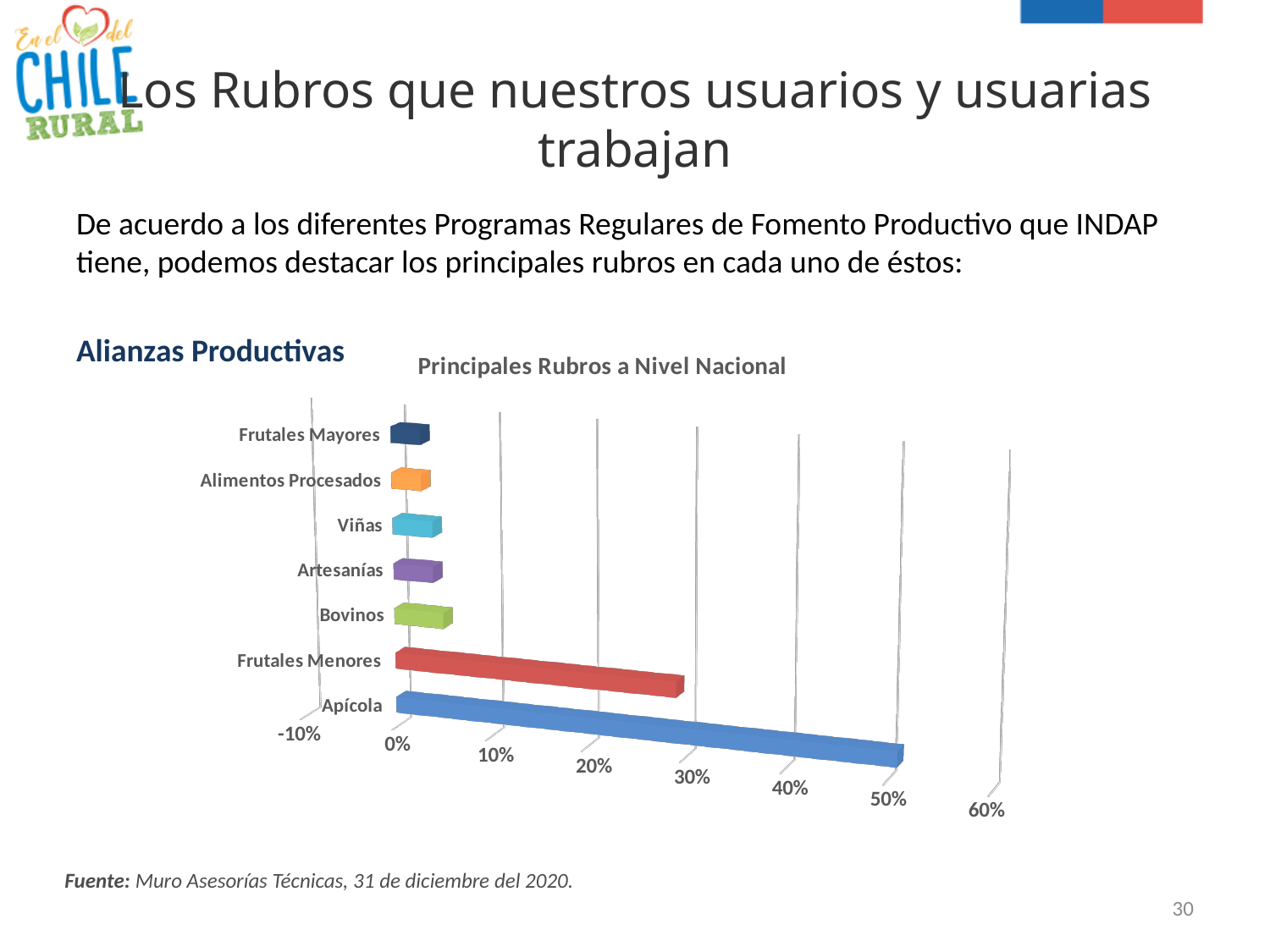
Is the value for Apícola greater or less than 40%? greater What is the title of the chart? Principales Rubros a Nivel Nacional Is the value for Bovinos greater or less than 10%? less Is the value for Frutales Menores greater or less than 20%? greater Which is larger, the value for Frutales Menores or the value for Bovinos? Frutales Menores What is the highest tick label shown on the value axis of the chart? 60% How many categories (rubros) are shown in the chart? 7 Which category has the highest value in the chart? Apícola Which is larger, the value for Apícola or the value for Frutales Menores? Apícola What type of chart is shown on the slide? bar chart